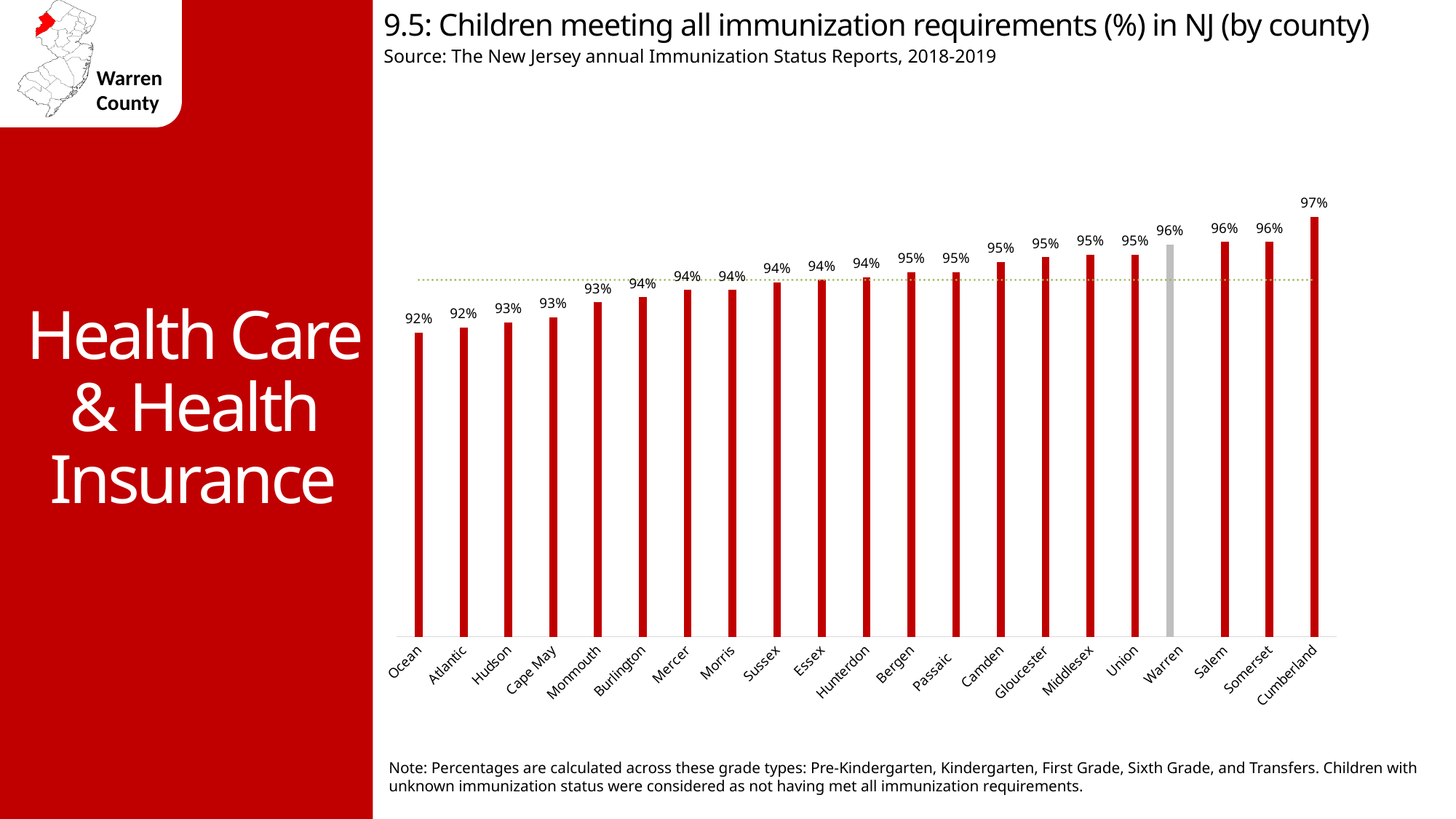
How many counties are shown on the chart? 21 Which has a higher value, Hudson or Salem? Salem What is the value shown for Cumberland County? 97% What is the difference in percentage points between Cumberland and Ocean counties? 5 percentage points What percentage is shown for Monmouth County? 93% What kind of chart is used on this slide? Bar chart What percentage is shown for Ocean County? 92% Which county's bar is coloured grey instead of red? Warren What is the value for Bergen County? 95% What percentage of children in Warren County met all immunization requirements? 96% Which county has the highest percentage of children meeting all immunization requirements? Cumberland Do the values rise or fall moving from left to right along the x axis? Rise